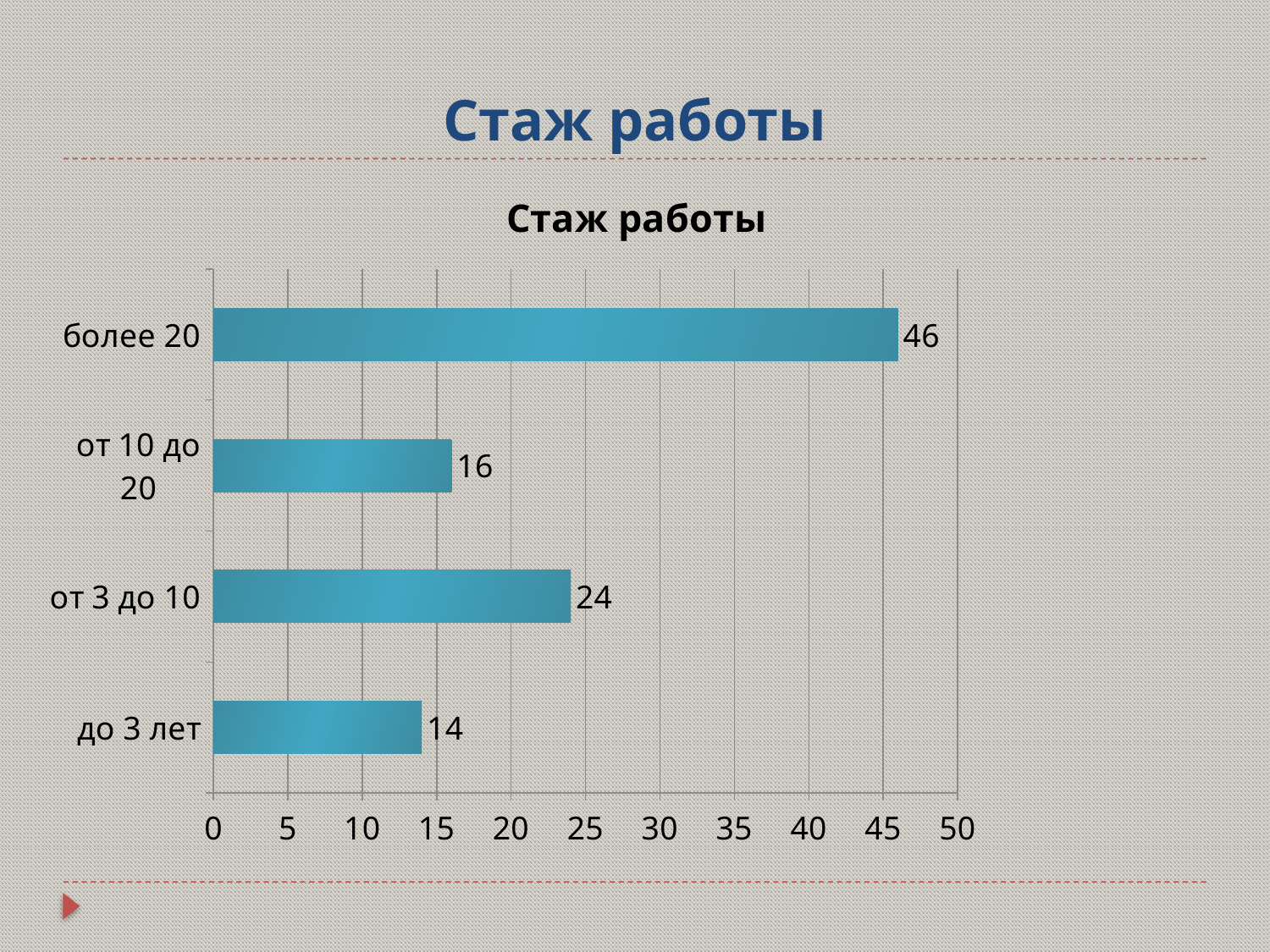
Which is larger, the value for "от 3 до 10" or the value for "от 10 до 20"? от 3 до 10 What is the value for "до 3 лет"? 14 How many categories are shown in the chart? 4 What is the difference between the values for "более 20" and "от 3 до 10"? 22 What is the title of the chart? Стаж работы What is the difference between the values for "от 10 до 20" and "до 3 лет"? 2 What is the value for "от 10 до 20"? 16 Which category has the highest value? более 20 What kind of chart is shown on the slide? bar chart What is the value for "более 20"? 46 Which category has the lowest value? до 3 лет What is the value for "от 3 до 10"? 24